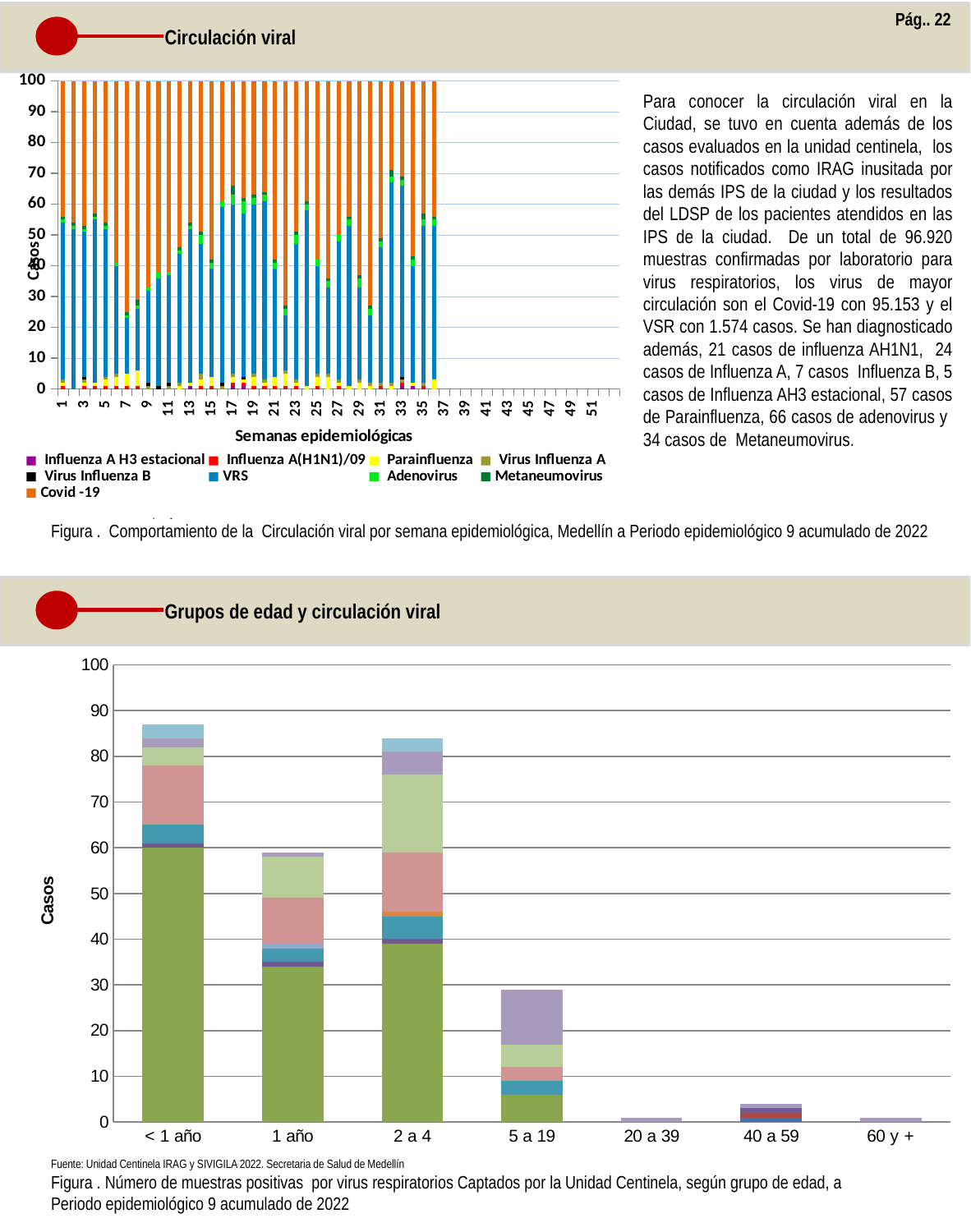
In the bottom chart (Grupos de edad y circulación viral), is the total for '5 a 19' greater or less than 20? greater In the bottom chart (Grupos de edad y circulación viral), how many age-group categories are shown on the x axis? 7 What kind of chart is the bottom chart (Grupos de edad y circulación viral)? bar chart In the top chart (Circulación viral), what is the total height of the stacked bar for week 1? 100 In the bottom chart (Grupos de edad y circulación viral), is the total for '40 a 59' greater or less than 10? less In the bottom chart (Grupos de edad y circulación viral), which has the larger total, '< 1 año' or '1 año'? < 1 año In the bottom chart (Grupos de edad y circulación viral), which age group has the tallest stacked bar? < 1 año What kind of chart is the top chart titled 'Circulación viral'? bar chart In the top chart (Circulación viral), how many series does the legend list? 9 In the bottom chart (Grupos de edad y circulación viral), is the total for '1 año' greater or less than 50? greater In the top chart (Circulación viral), what is the title of the x axis? Semanas epidemiológicas In the top chart (Circulación viral), which series is shown in orange? Covid -19